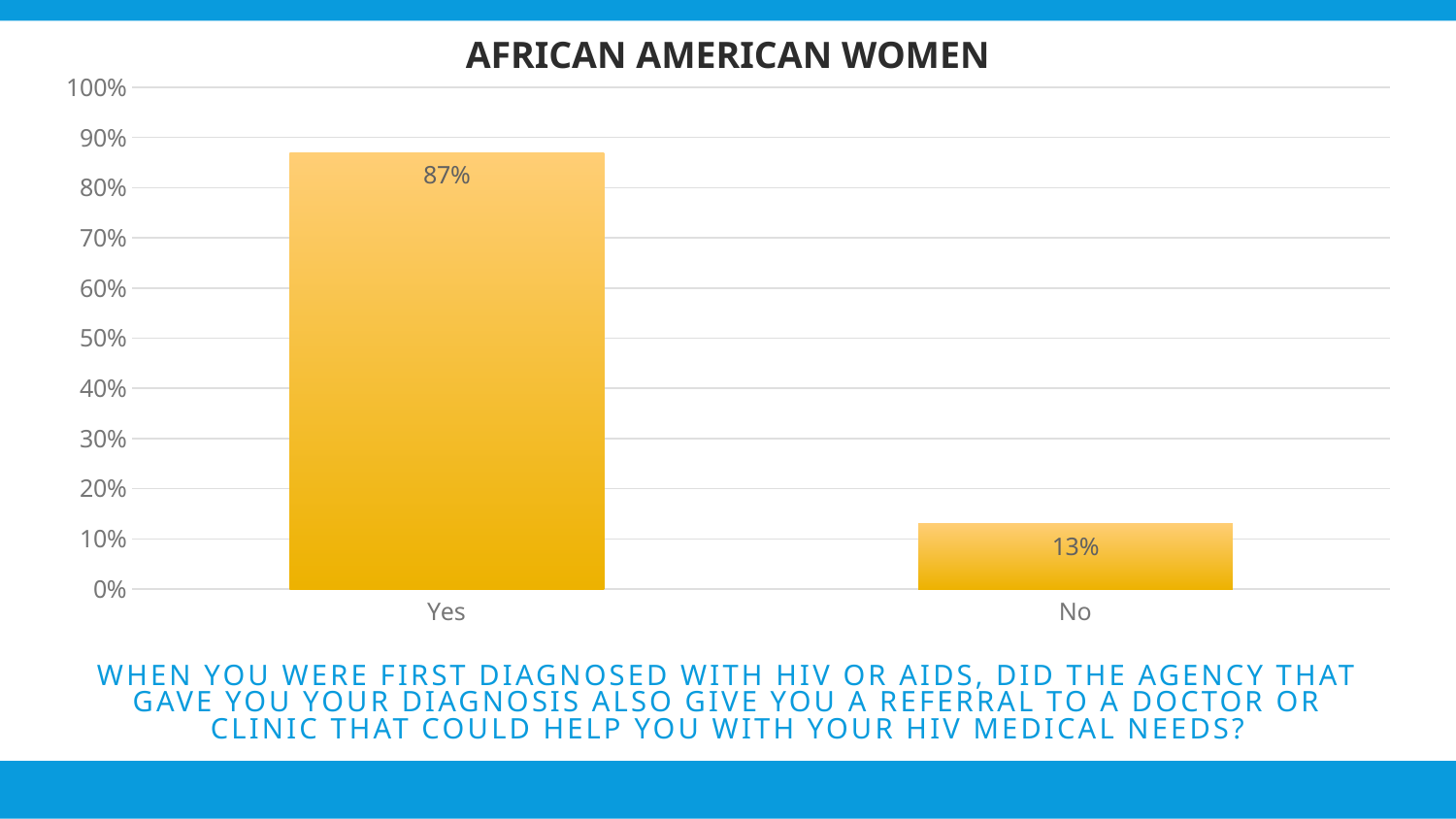
Which category has the lowest value? No What is the difference between the values for Yes and No? 74% What is the title of the chart? AFRICAN AMERICAN WOMEN Is the value for Yes greater or less than 80%? greater Is the value for No greater or less than 20%? less What is the value for No? 13% What kind of chart is shown on the slide? bar chart What is the maximum value shown on the y axis? 100% Which is larger, the value for Yes or the value for No? Yes How many categories are shown on the x axis? 2 Which category has the highest value? Yes What is the value for Yes? 87%